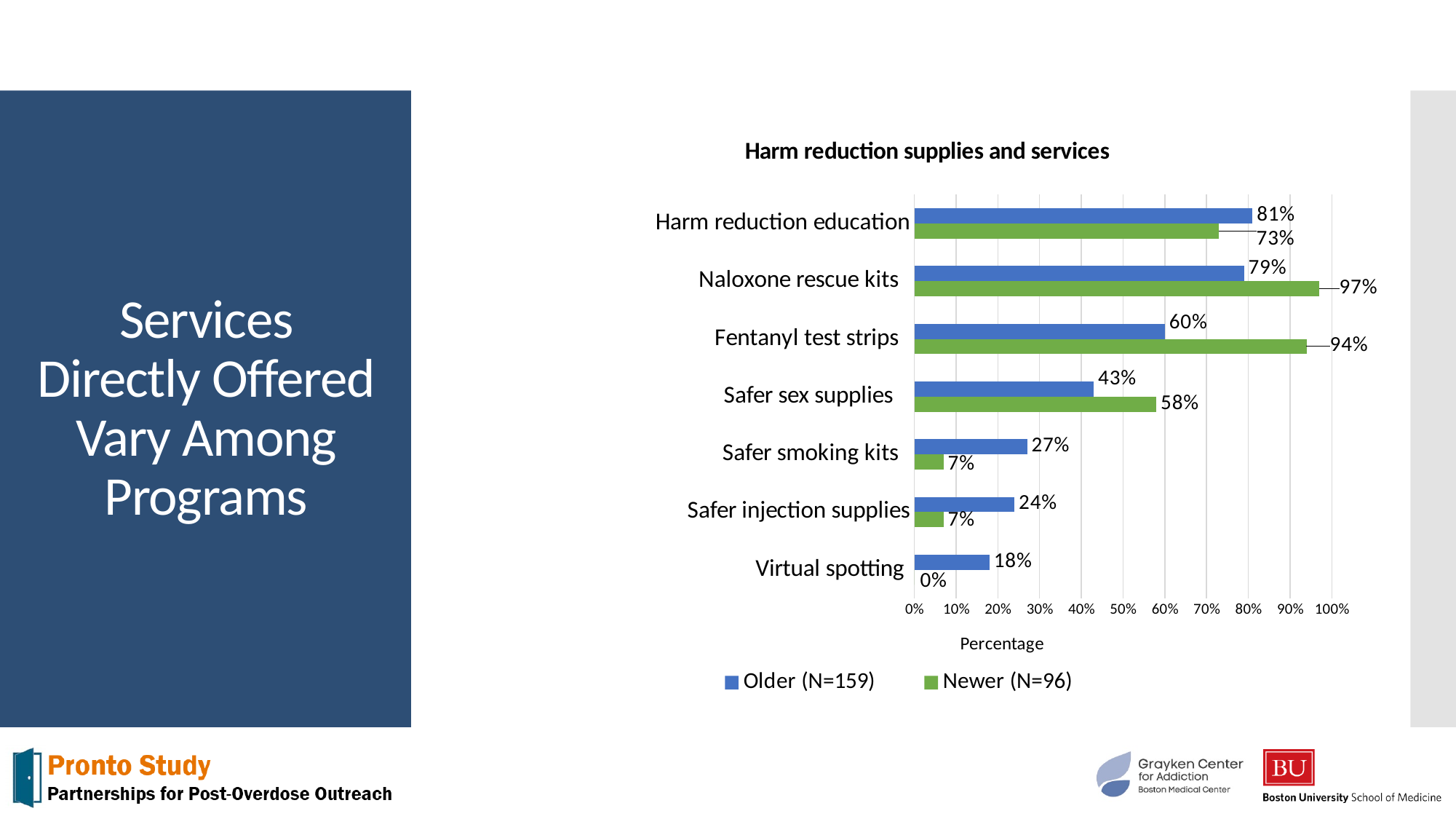
Which service has the highest value for the Newer (N=96) series? Naloxone rescue kits How many services are listed on the chart? 7 What percentage of Newer programs offer Naloxone rescue kits? 97% Is the Older value for Safer sex supplies greater or less than 50%? less What kind of chart is shown on the slide? bar chart How many series does the legend list? 2 What is the difference between the Newer and Older values for Fentanyl test strips? 34% For Safer smoking kits, which series has the larger value, Older or Newer? Older Which service has the lowest value for the Older (N=159) series? Virtual spotting What percentage of Older programs offer Harm reduction education? 81% What percentage of Newer programs offer Virtual spotting? 0% What is the title of the chart? Harm reduction supplies and services